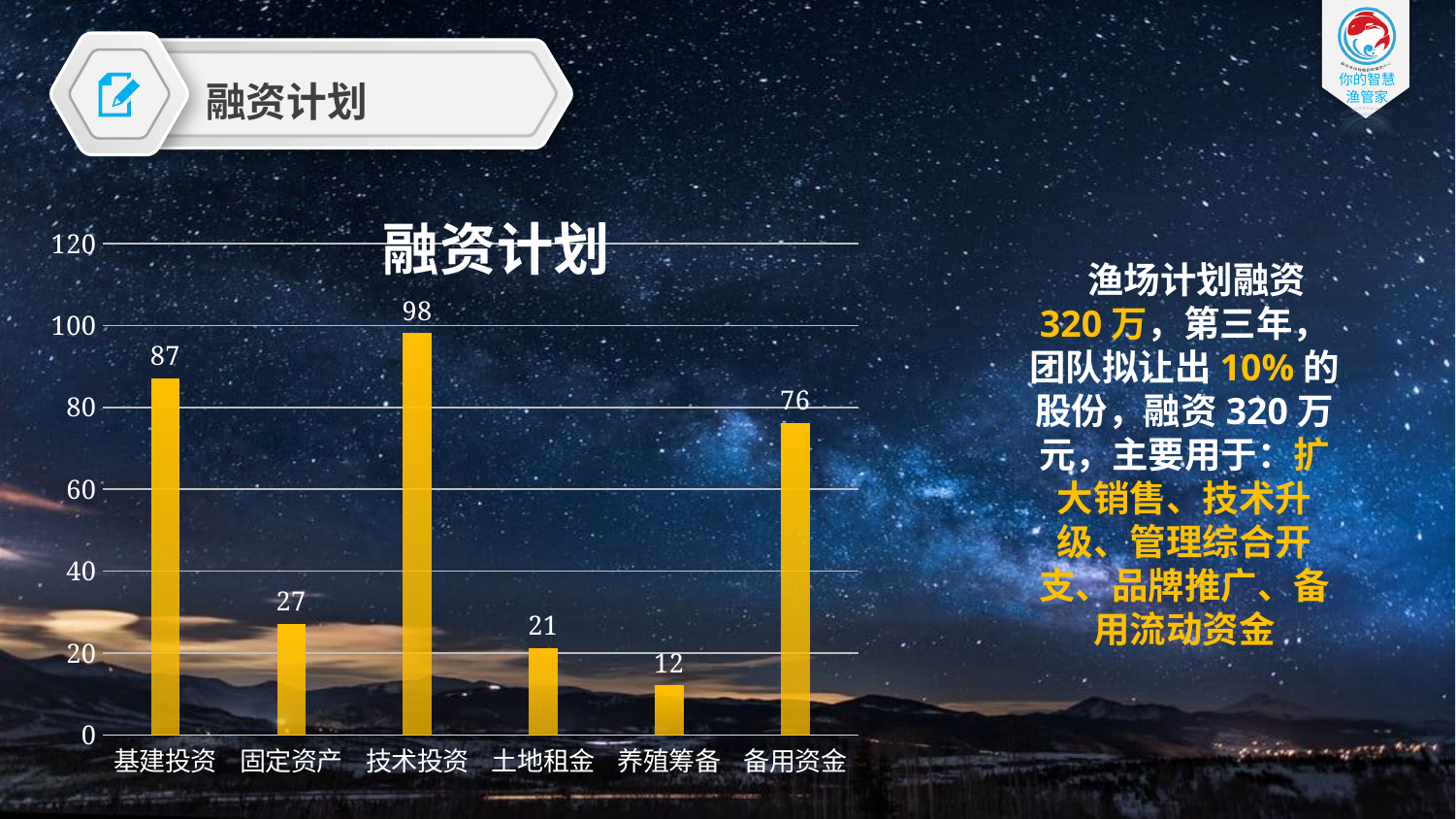
Which category has the highest value? 技术投资 What is the value for 土地租金? 21 Which category has the lowest value? 养殖筹备 Is the value for 备用资金 greater or less than 60? greater Which is larger, the value for 固定资产 or the value for 土地租金? 固定资产 What is the title of the chart? 融资计划 What is the difference between the values for 基建投资 and 备用资金? 11 What is the difference between the values for 技术投资 and 养殖筹备? 86 What is the value for 技术投资? 98 How many categories are shown on the x axis? 6 What is the value for 养殖筹备? 12 What kind of chart is shown on the slide? bar chart